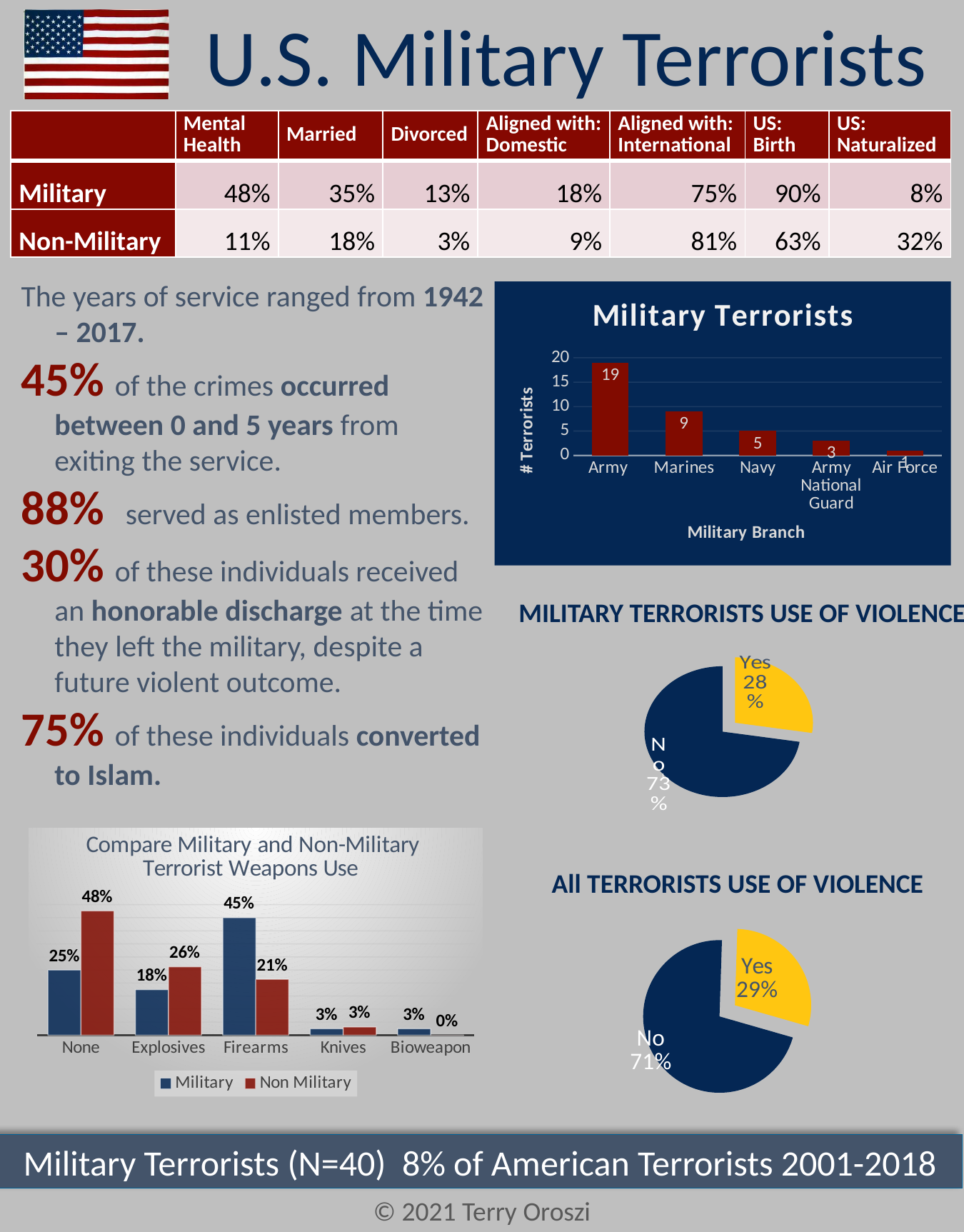
In the 'Military Terrorists' chart, what is the difference between the Army and Marines values? 10 In the 'Compare Military and Non-Military Terrorist Weapons Use' chart, which is larger for Explosives: Military or Non Military? Non Military In the 'Compare Military and Non-Military Terrorist Weapons Use' chart, which weapon category has the highest Military value? Firearms How many military branches are shown in the 'Military Terrorists' chart? 5 In the 'All TERRORISTS USE OF VIOLENCE' pie chart, what share is 'Yes'? 29% In the 'Military Terrorists' chart, do the values rise or fall from Army to Air Force along the x axis? fall How many series does the legend of the 'Compare Military and Non-Military Terrorist Weapons Use' chart list? 2 What kind of chart is 'MILITARY TERRORISTS USE OF VIOLENCE'? pie chart In the 'Military Terrorists' chart, how many terrorists are from the Army? 19 In the 'Compare Military and Non-Military Terrorist Weapons Use' chart, what is the Non Military value for None? 48% In the 'MILITARY TERRORISTS USE OF VIOLENCE' pie chart, what share is 'No'? 73% In the 'Military Terrorists' chart, which military branch has the lowest number of terrorists? Air Force